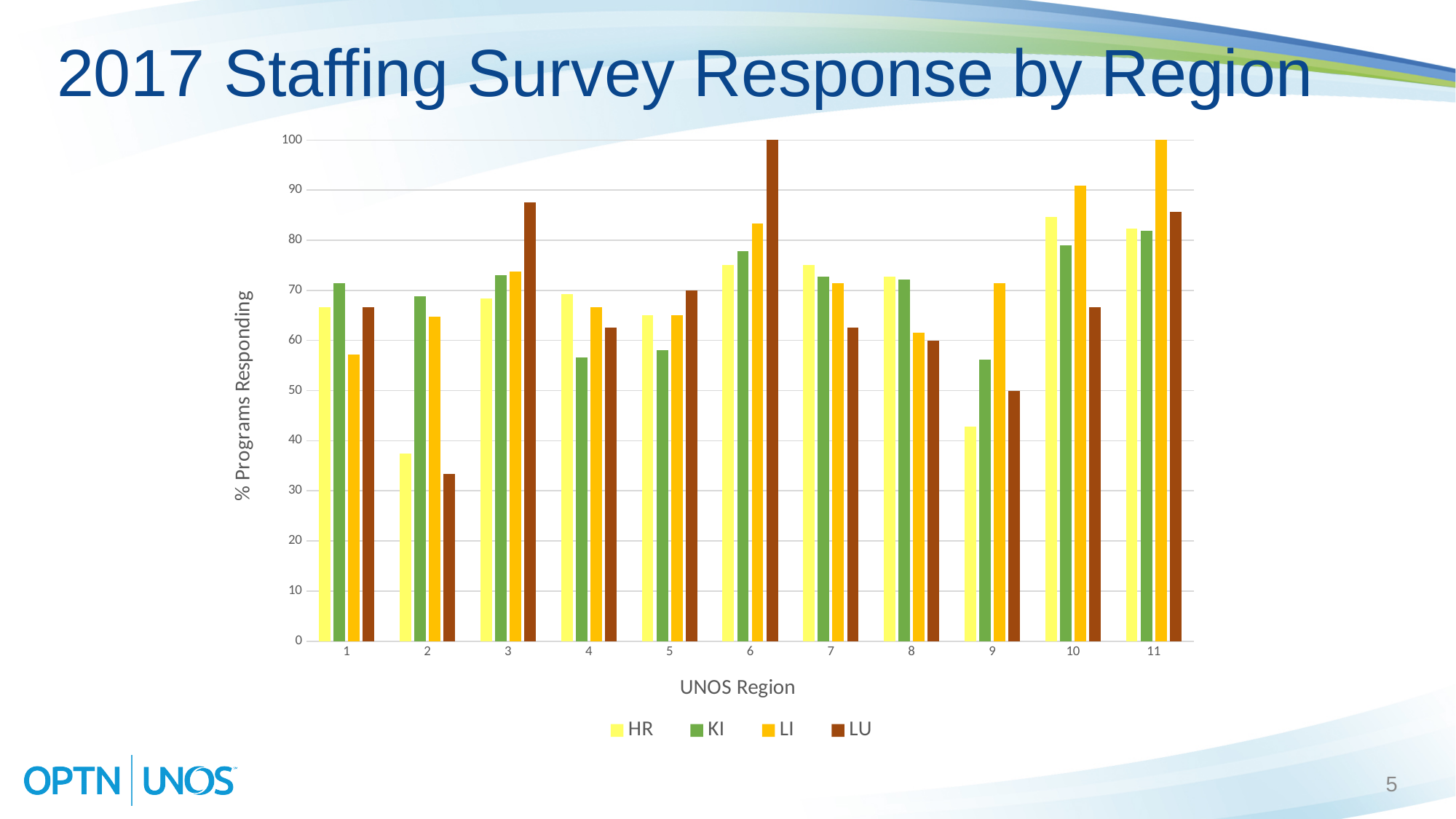
Is the LU value for UNOS Region 3 greater or less than 90? less In which UNOS Region is the LU value highest? 6 Is the HR value for UNOS Region 2 greater or less than 40? less What kind of chart is shown on the slide? bar chart What is the LI value for UNOS Region 11? 100 How many series does the legend list? 4 In which UNOS Region is the HR value lowest? 2 Is the LI value for UNOS Region 10 greater or less than 90? greater How many UNOS regions are shown on the x axis? 11 What is the LU value for UNOS Region 6? 100 In UNOS Region 1, which is larger, the KI value or the LI value? KI What is the label of the y axis? % Programs Responding